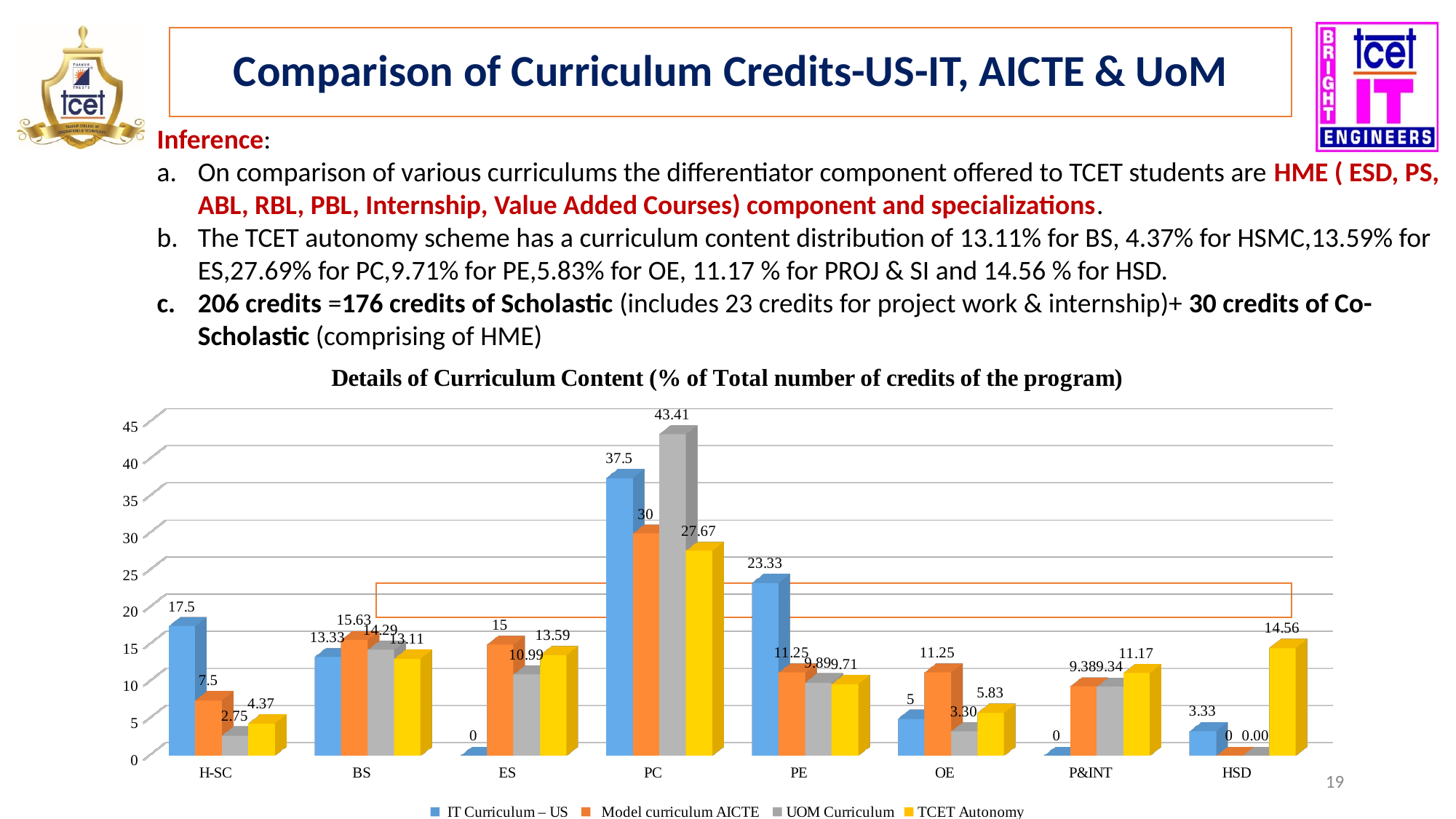
For OE, which is larger: the Model curriculum AICTE value or the TCET Autonomy value? Model curriculum AICTE Which category has the lowest Model curriculum AICTE value? HSD What is the title of the chart? Details of Curriculum Content (% of Total number of credits of the program) Which category has the highest TCET Autonomy value? PC How many categories are shown on the x axis of the chart? 8 Is the IT Curriculum – US value for PC greater or less than 35? greater How many series does the chart legend list? 4 What is the UOM Curriculum value for PC? 43.41 What type of chart is shown on the slide? bar chart What is the TCET Autonomy value for HSD? 14.56 What is the difference between the IT Curriculum – US value and the Model curriculum AICTE value for H-SC? 10 What is the IT Curriculum – US value for PE? 23.33